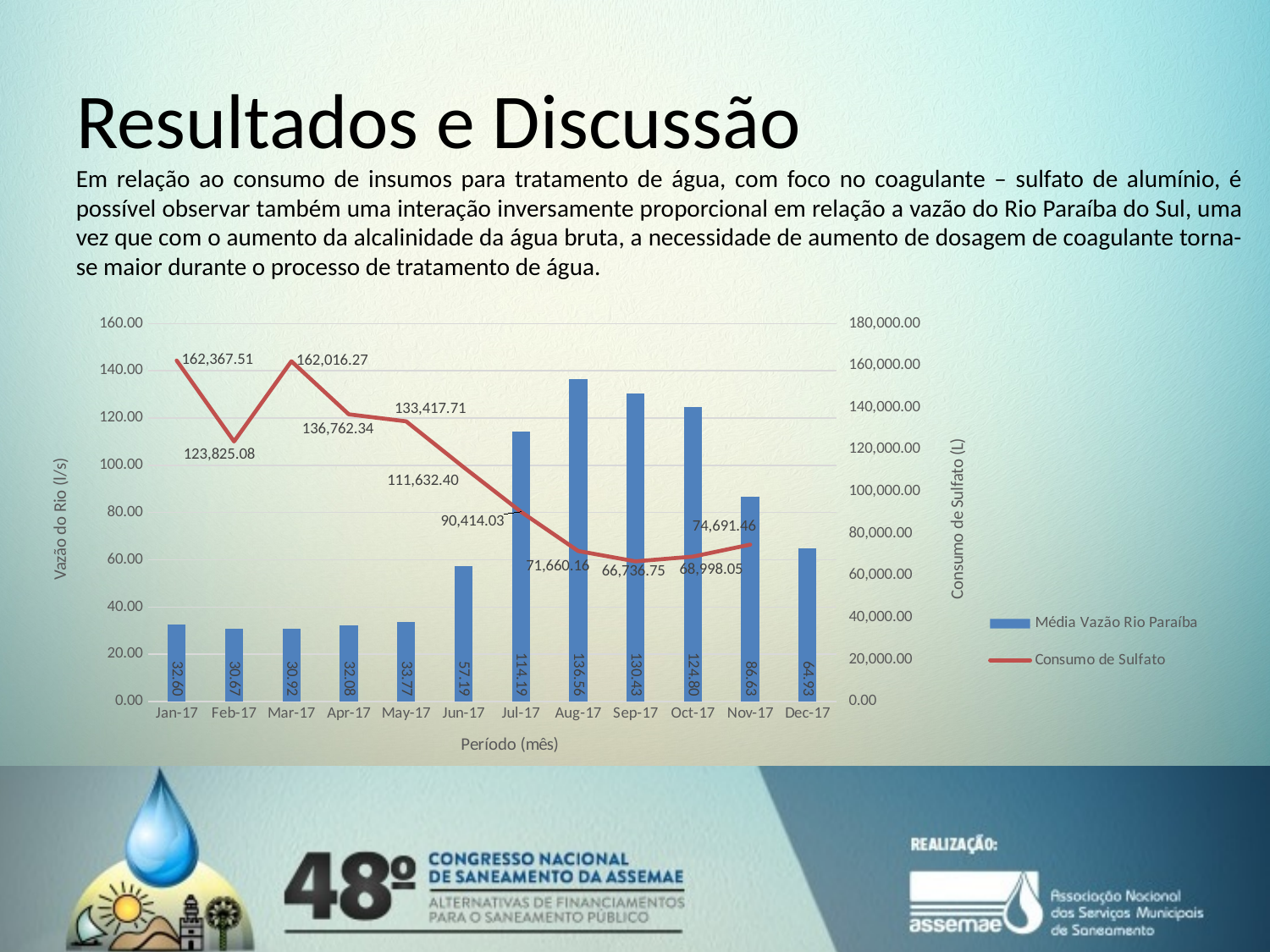
What kind of chart is shown on the slide? Combined bar and line chart Which month has the lowest labelled Consumo de Sulfato value? Sep-17 How many months are shown on the x axis? 12 What is the Média Vazão Rio Paraíba value for Aug-17? 136.56 How many series does the legend list? 2 What is the difference between the Média Vazão Rio Paraíba values for Aug-17 and Jul-17? 22.37 Which is larger, the Média Vazão Rio Paraíba for Sep-17 or for Oct-17? Sep-17 What is the title of the right-hand vertical axis? Consumo de Sulfato (L) What is the Consumo de Sulfato value for Jan-17? 162,367.51 Which month has the lowest Média Vazão Rio Paraíba? Feb-17 Which month has the highest Média Vazão Rio Paraíba? Aug-17 Does the Consumo de Sulfato line rise or fall from Mar-17 to Sep-17? Fall